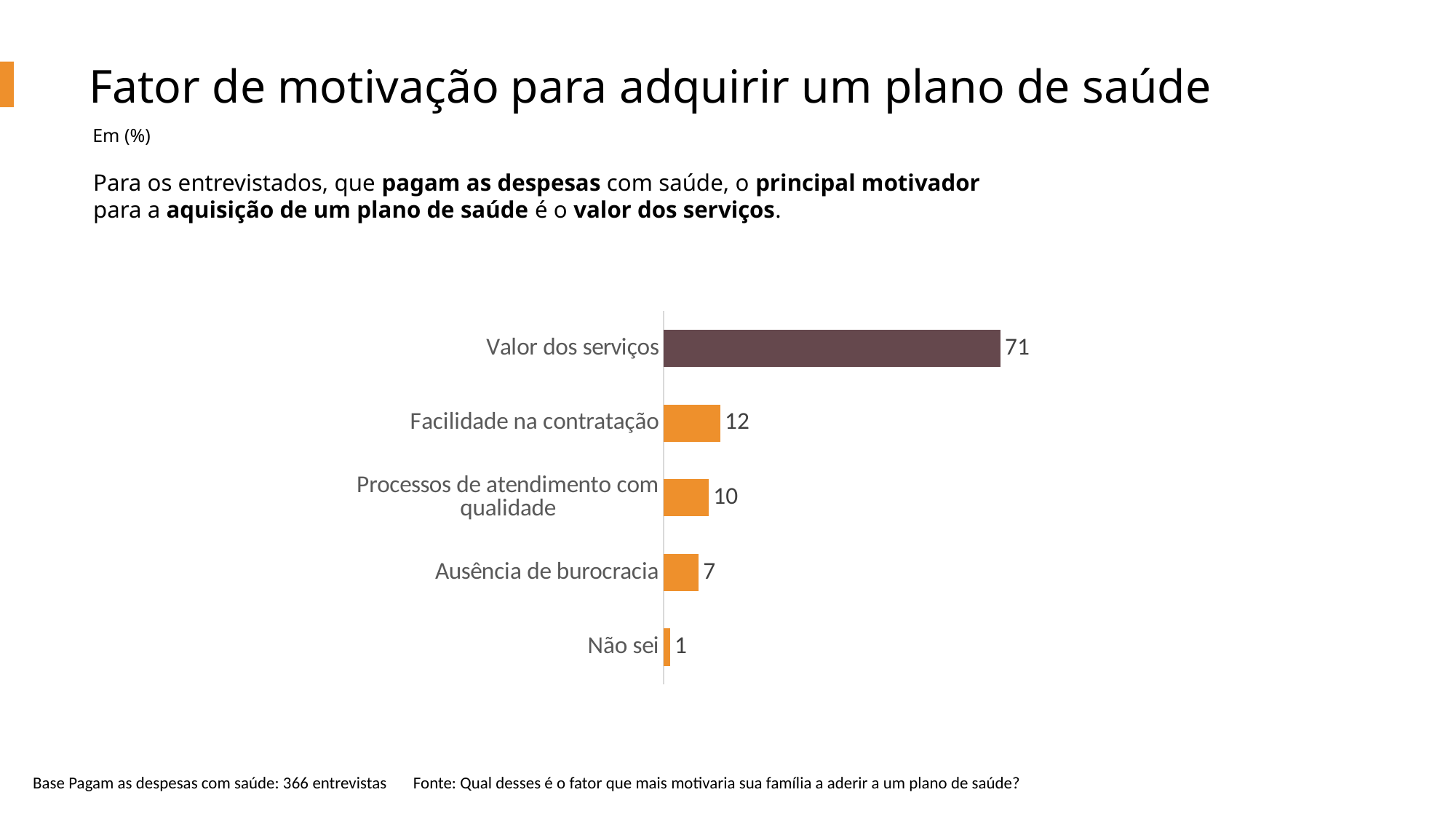
Which bar is shown in a different colour from the others? Valor dos serviços What is the value for Não sei? 1 What is the value for Facilidade na contratação? 12 What is the value for Processos de atendimento com qualidade? 10 Which is larger, the value for Facilidade na contratação or the value for Ausência de burocracia? Facilidade na contratação Which category has the lowest value? Não sei Which category has the highest value? Valor dos serviços What is the difference between the values for Valor dos serviços and Facilidade na contratação? 59 How many categories are shown in the chart? 5 What is the value for Valor dos serviços? 71 What kind of chart is shown on the slide? Bar chart What is the value for Ausência de burocracia? 7